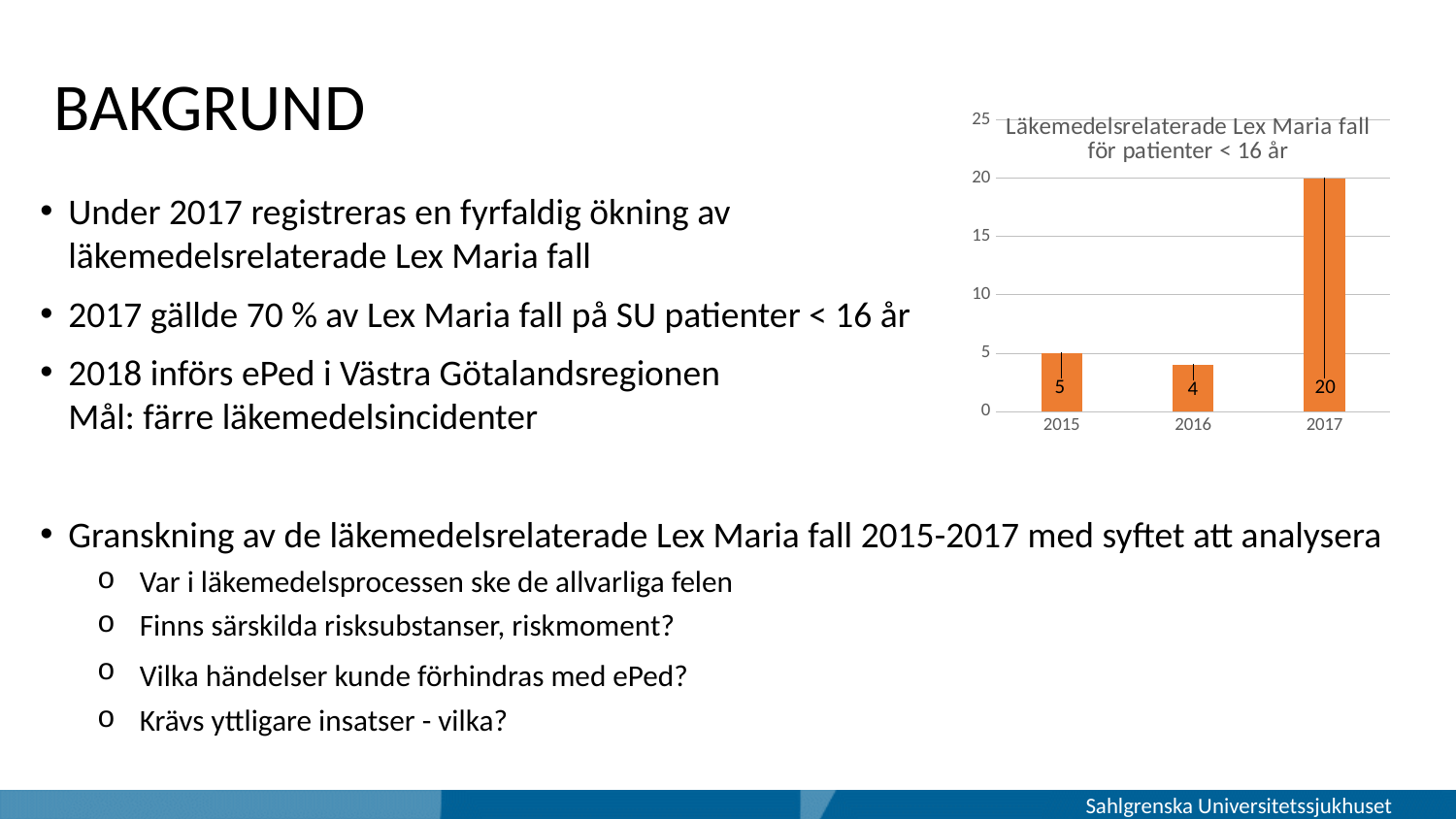
Which is larger, the value for 2015 or the value for 2016? 2015 Which year has the lowest value in the chart? 2016 Which year has the highest value in the chart? 2017 What is the difference between the values for 2015 and 2016? 1 How many years are shown on the x axis of the chart? 3 What kind of chart is shown on the slide? bar chart What is the difference between the values for 2017 and 2015? 15 Is the value for 2017 greater or less than 15? greater What is the value for 2016 in the chart? 4 What is the value for 2015 in the chart? 5 What is the title of the chart? Läkemedelsrelaterade Lex Maria fall för patienter < 16 år What is the value for 2017 in the chart? 20